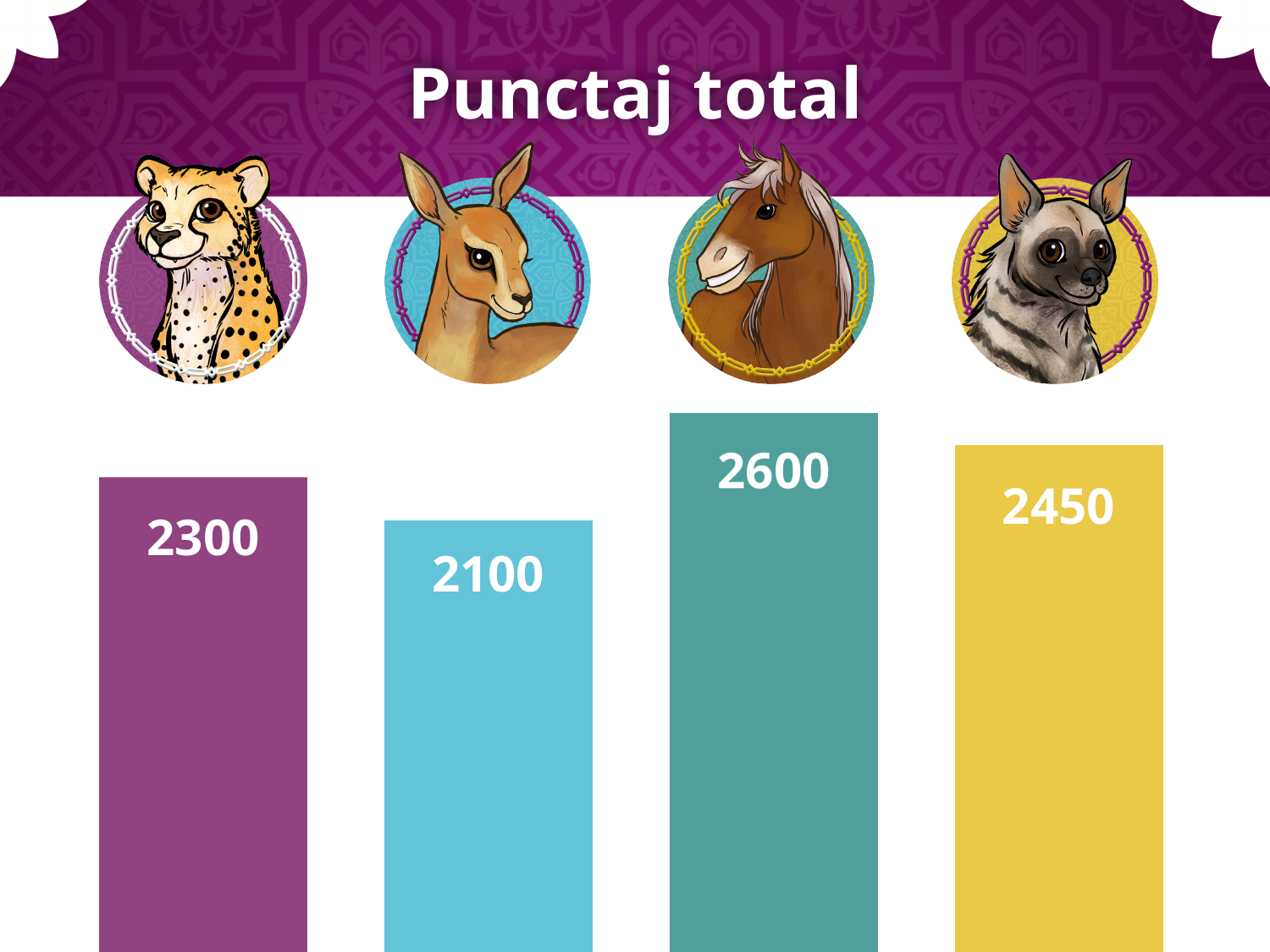
What is the value of the first (purple) bar on the left? 2300 What is the difference between the highest and lowest bar values? 500 Which bar has the lowest value? the second (light blue) bar, 2100 What is the difference between the yellow bar and the purple bar? 150 What is the value of the second (light blue) bar? 2100 Which is larger, the value of the purple bar or the yellow bar? the yellow bar (2450) What is the title of the chart? Punctaj total Which bar has the highest value? the third (teal) bar, 2600 What is the value of the fourth (yellow) bar on the right? 2450 How many bars does the chart have? 4 What is the value of the third (teal) bar? 2600 What kind of chart is shown on the slide? bar chart